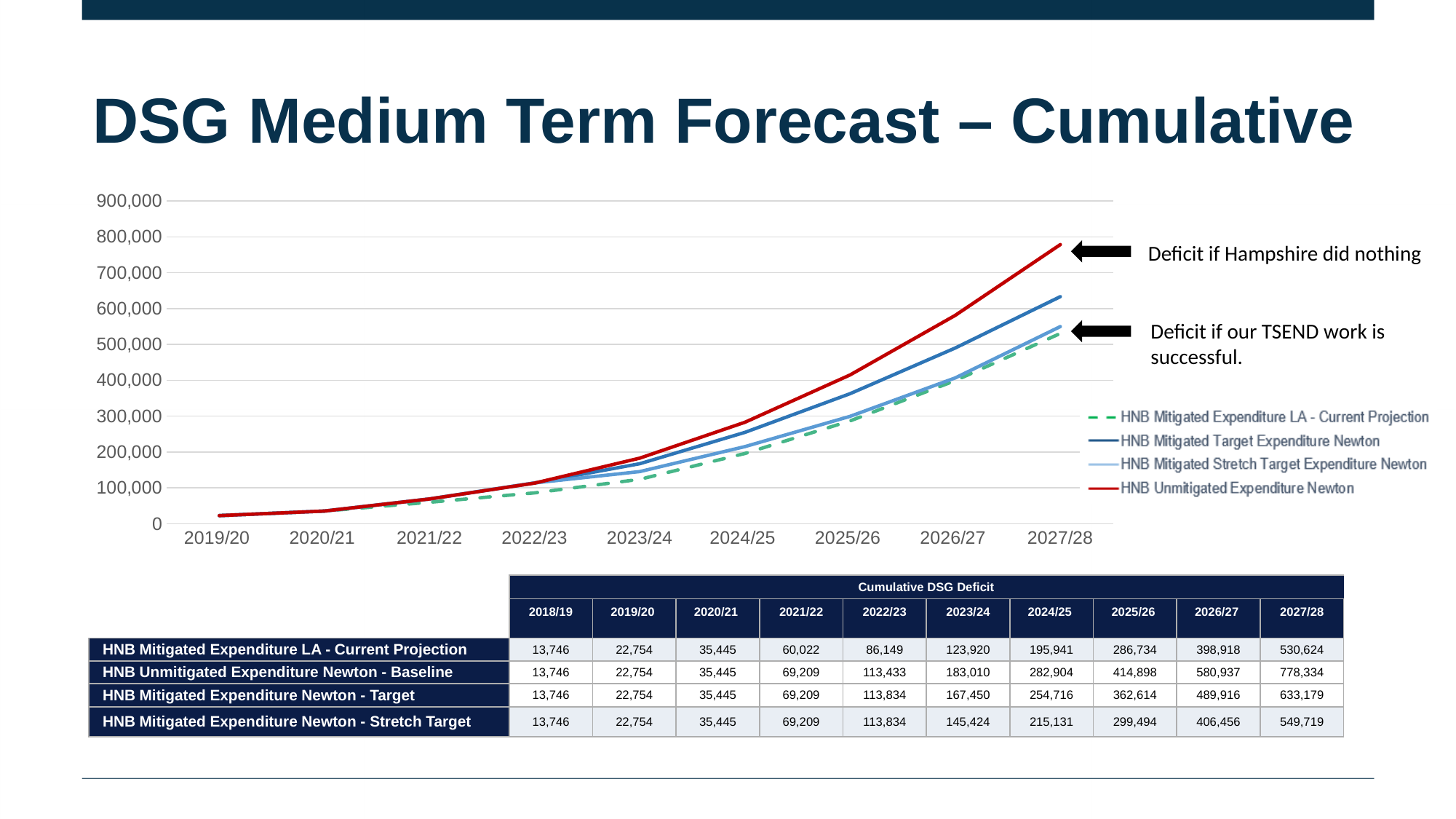
Do the values of the series rise or fall from 2019/20 to 2027/28? Rise What type of chart is shown on the slide? Line chart What is the difference between the 2027/28 values for HNB Unmitigated Expenditure Newton and HNB Mitigated Expenditure LA - Current Projection? 247,710 Is the value for HNB Unmitigated Expenditure Newton in 2027/28 greater or less than 700,000? greater How many series does the chart legend list? 4 How many years are plotted along the x axis of the chart? 9 Which series has the highest value in 2027/28? HNB Unmitigated Expenditure Newton In 2025/26, which is larger: HNB Mitigated Target Expenditure Newton or HNB Mitigated Stretch Target Expenditure Newton? HNB Mitigated Target Expenditure Newton What is the cumulative deficit for HNB Mitigated Expenditure LA - Current Projection in 2027/28? 530,624 Which series has the lowest value in 2027/28? HNB Mitigated Expenditure LA - Current Projection What is the cumulative deficit for HNB Unmitigated Expenditure Newton in 2027/28? 778,334 Which series is drawn with a dashed line in the chart? HNB Mitigated Expenditure LA - Current Projection